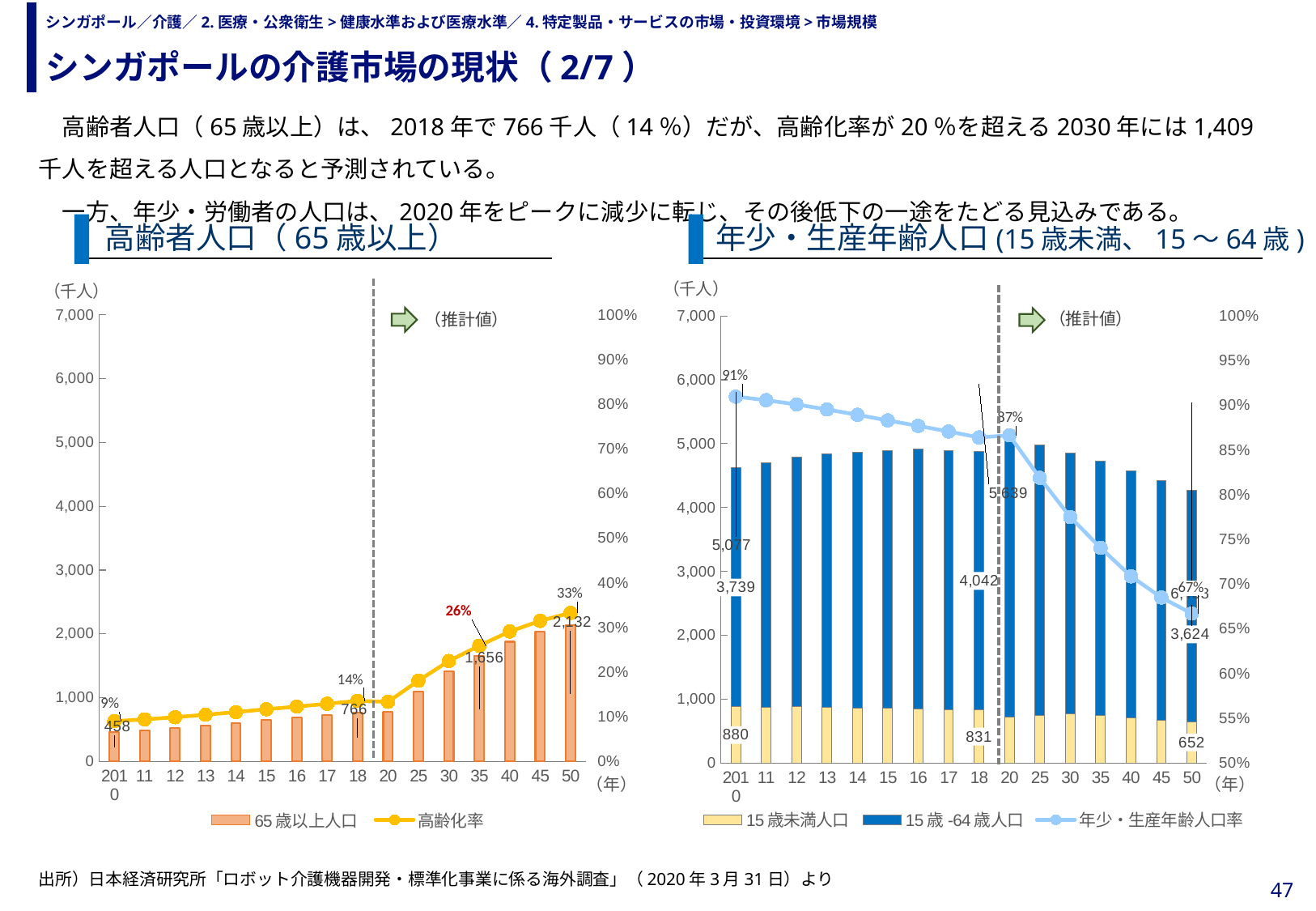
In the left chart (高齢者人口（65歳以上）), what is the 65歳以上人口 value for 2018? 766 In the right chart (年少・生産年齢人口), what is the 15歳-64歳人口 value for 2050? 3,624 In the right chart (年少・生産年齢人口), does the 年少・生産年齢人口率 line rise or fall from 2010 to 2050? fall In the left chart (高齢者人口（65歳以上）), what is the 65歳以上人口 value for 2010? 458 In the left chart (高齢者人口（65歳以上）), what is the difference between the 65歳以上人口 values for 2050 and 2018? 1,366 In the right chart (年少・生産年齢人口), what is the 15歳未満人口 value for 2010? 880 In the left chart (高齢者人口（65歳以上）), which year has the highest 65歳以上人口? 2050 In the right chart (年少・生産年齢人口), how many series does the legend list? 3 In the right chart (年少・生産年齢人口), what is the total of the stacked bar for 2010 (15歳未満人口 plus 15歳-64歳人口)? 4,619 In the left chart (高齢者人口（65歳以上）), what is the 高齢化率 for 2050? 33% In the left chart (高齢者人口（65歳以上）), does the 高齢化率 line rise or fall from 2010 to 2050? rise In the left chart (高齢者人口（65歳以上）), how many series does the legend list? 2